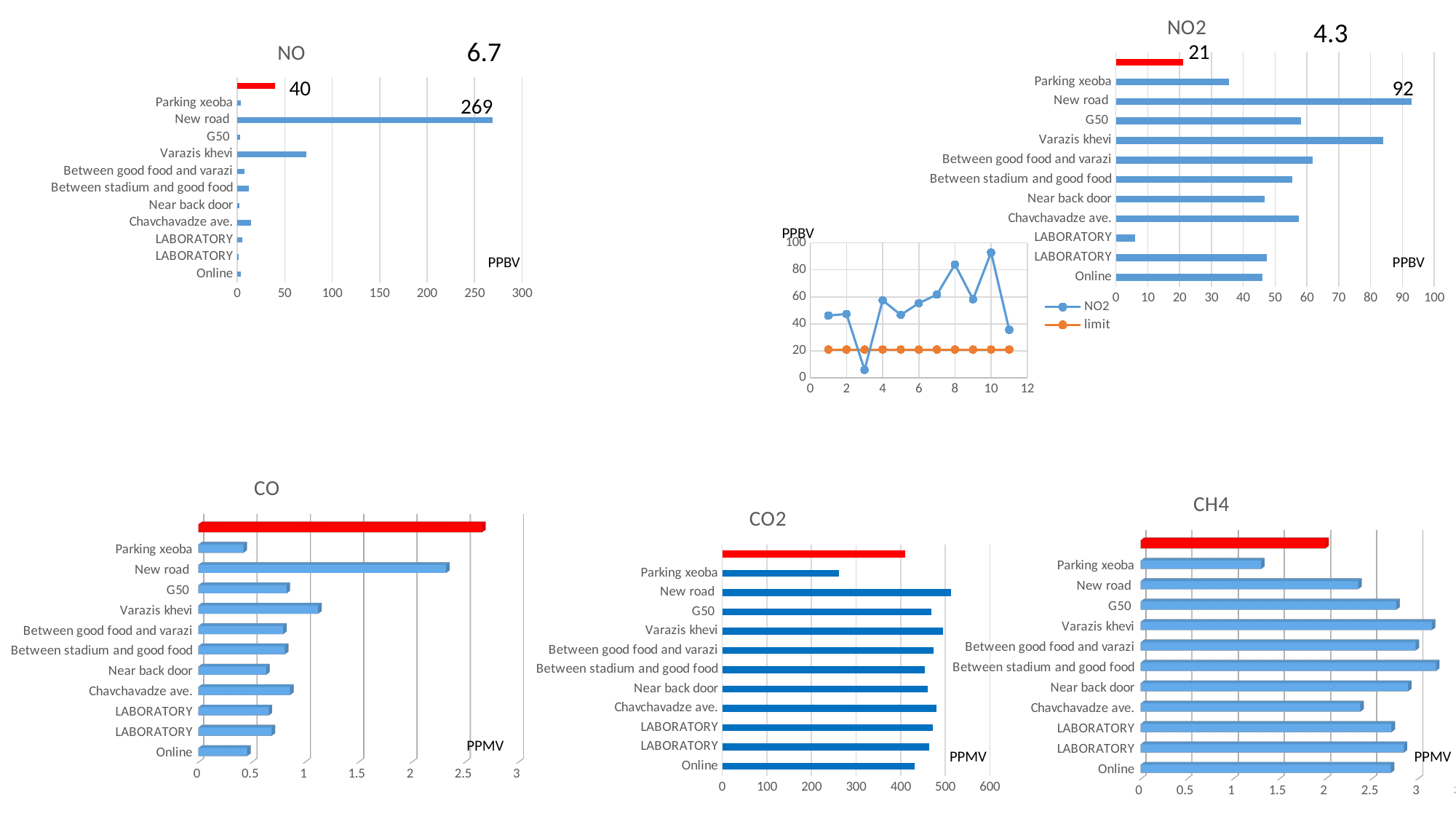
In the NO chart, which category has the highest value? New road In the NO2 bar chart, which category has the highest value? New road In the CO chart, is the value for New road greater or less than 2? greater In the CH4 chart, is the value for Parking xeoba greater or less than 1.5? less In the NO chart, what is the value for New road? 269 What kind of chart is the small PPBV chart with the NO2 and limit legend? line chart In the CO2 chart, which category has the lowest value? Parking xeoba In the NO2 bar chart, what is the value for New road? 92 What kind of chart is the NO chart? bar chart How many series does the legend of the NO2 line chart (PPBV) list? 2 How many categories are shown on the y axis of the CO chart? 11